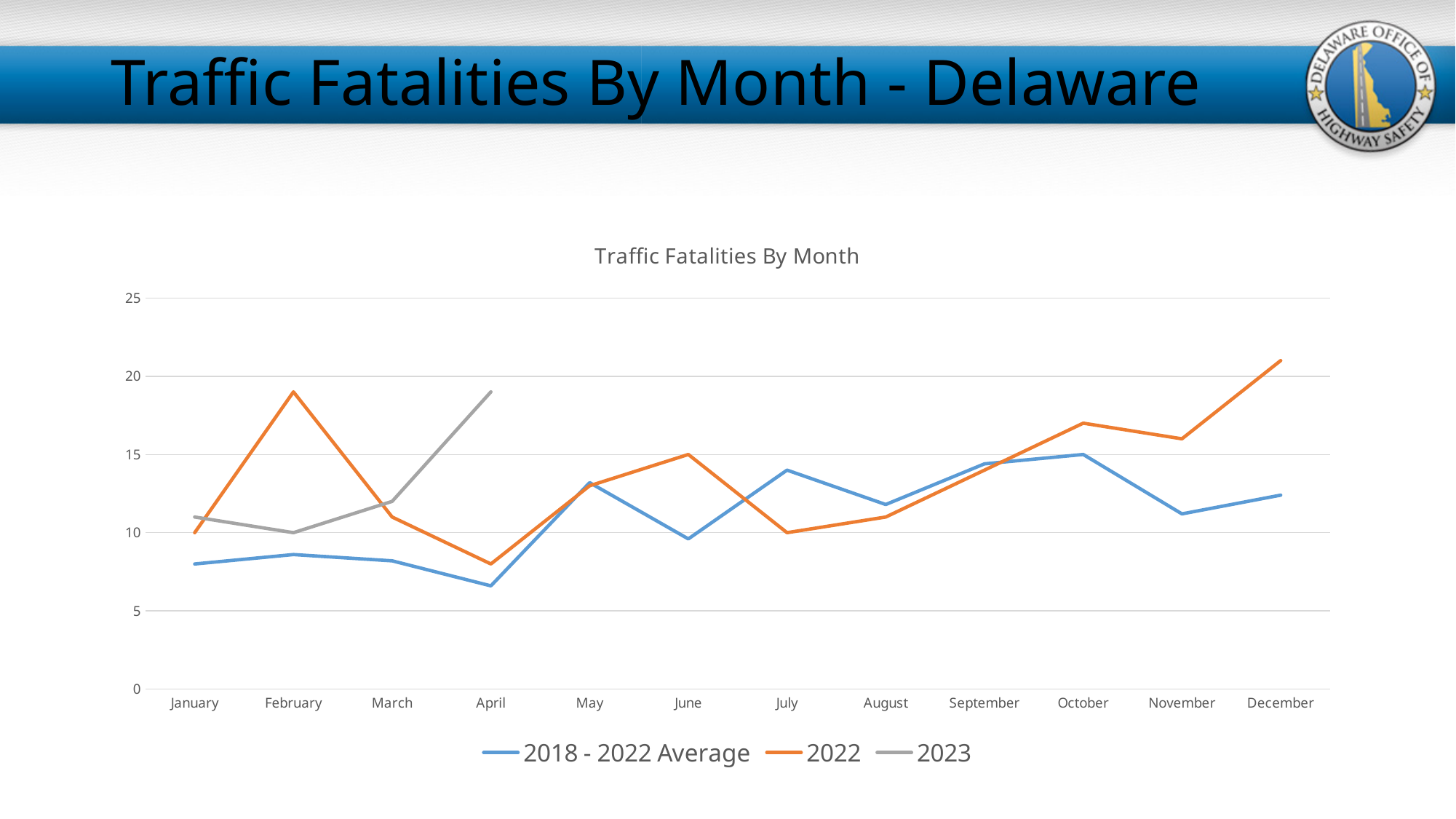
How many months are shown on the x axis? 12 In which month is the 2022 series highest? December Does the 2023 series rise or fall from March to April? rise Is the 2022 value for February greater or less than 15? greater Is the 2023 value for April greater or less than 15? greater How many series does the legend list? 3 What kind of chart is shown on the slide? line chart What are the three series listed in the legend? 2018 - 2022 Average, 2022, 2023 In December, which is larger: the 2022 value or the 2018 - 2022 Average value? 2022 In which month is the 2022 series lowest? April Is the 2022 value for December greater or less than 20? greater In which month is the 2018 - 2022 Average series lowest? April